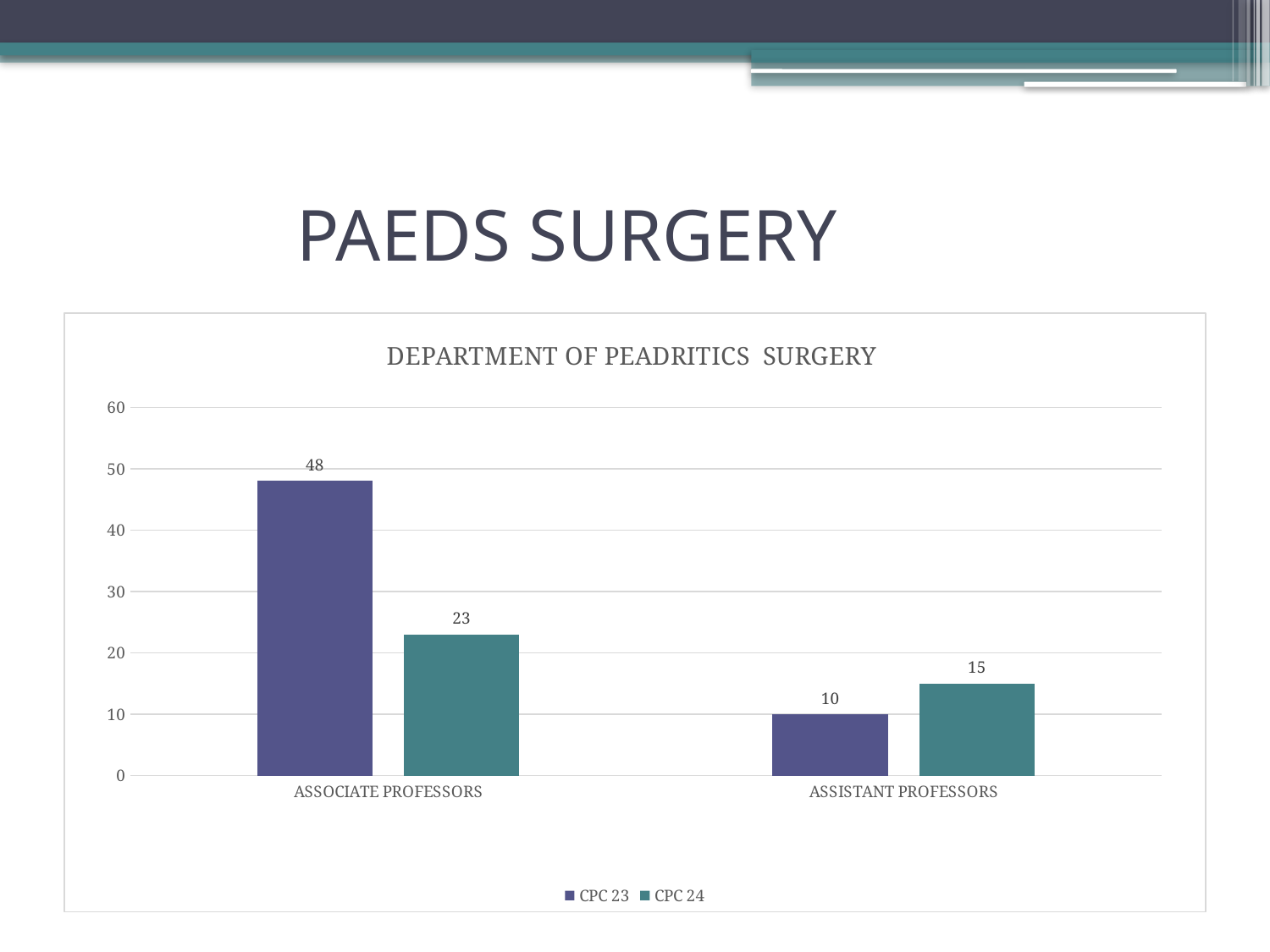
What is the CPC 24 value for Assistant Professors? 15 Which category has the highest CPC 23 value? Associate Professors What is the CPC 23 value for Associate Professors? 48 What is the title of the chart? DEPARTMENT OF PEADRITICS SURGERY What kind of chart is shown on the slide? Bar chart Is the CPC 24 value for Associate Professors greater or less than 20? greater Which category has the lowest CPC 24 value? Assistant Professors For Assistant Professors, which is larger: CPC 23 or CPC 24? CPC 24 What is the CPC 23 value for Assistant Professors? 10 How many categories are shown on the x axis? 2 What is the difference between the CPC 23 and CPC 24 values for Associate Professors? 25 How many series does the legend list? 2